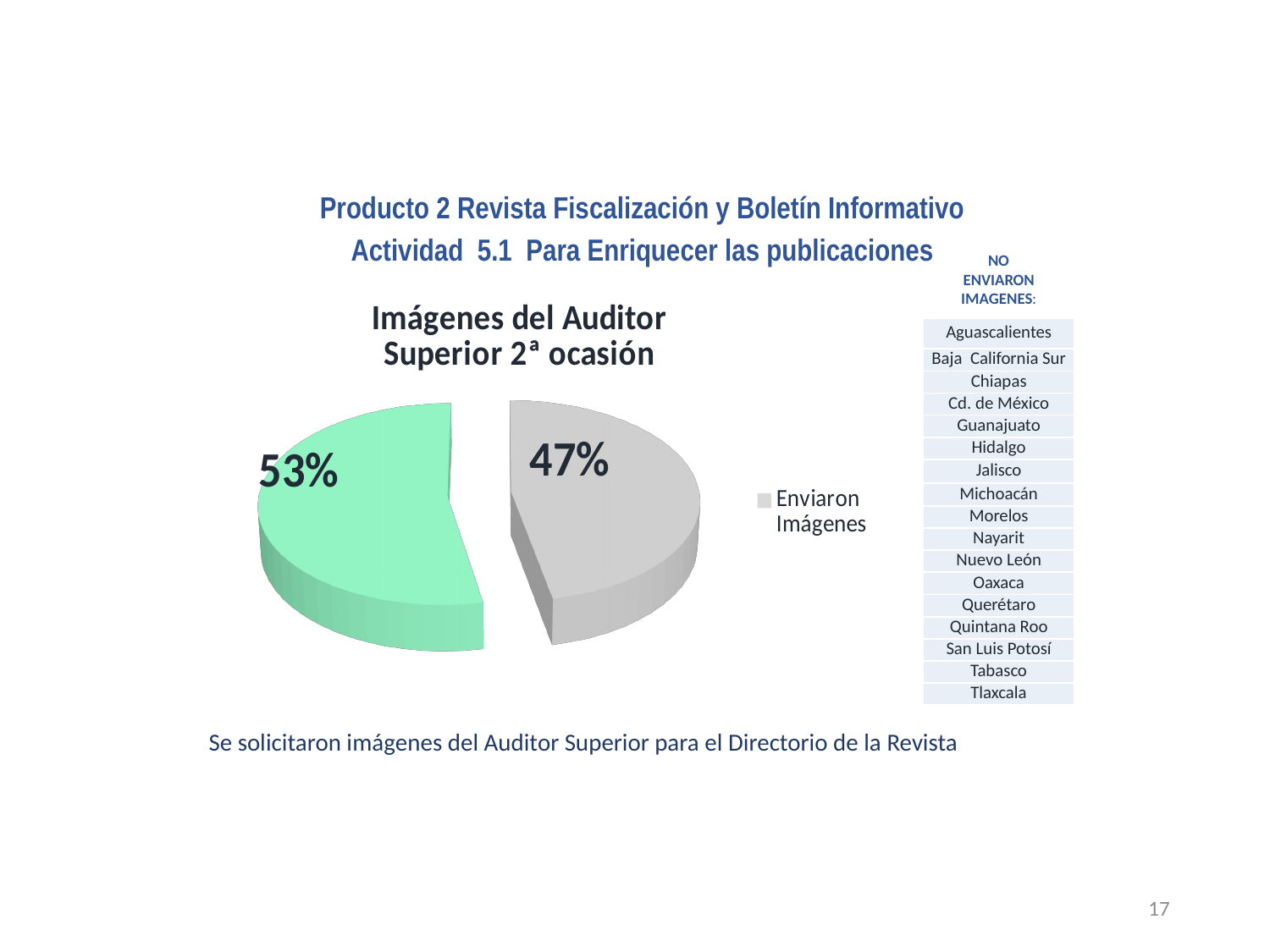
Which slice is larger, the green slice or the grey "Enviaron Imágenes" slice? the green slice What is the title of the pie chart? Imágenes del Auditor Superior 2ª ocasión What kind of chart is shown on the slide? pie chart What is the difference in percentage points between the two slices of the pie chart? 6 What is the share of the smallest slice in the pie chart? 47% What colour is the slice labelled "Enviaron Imágenes" in the legend? grey What share of the pie does the green slice represent? 53% What is the share of the largest slice in the pie chart? 53% How many slices does the pie chart have? 2 How many entries does the legend of the pie chart list? 1 What percentage of the pie corresponds to "Enviaron Imágenes"? 47%